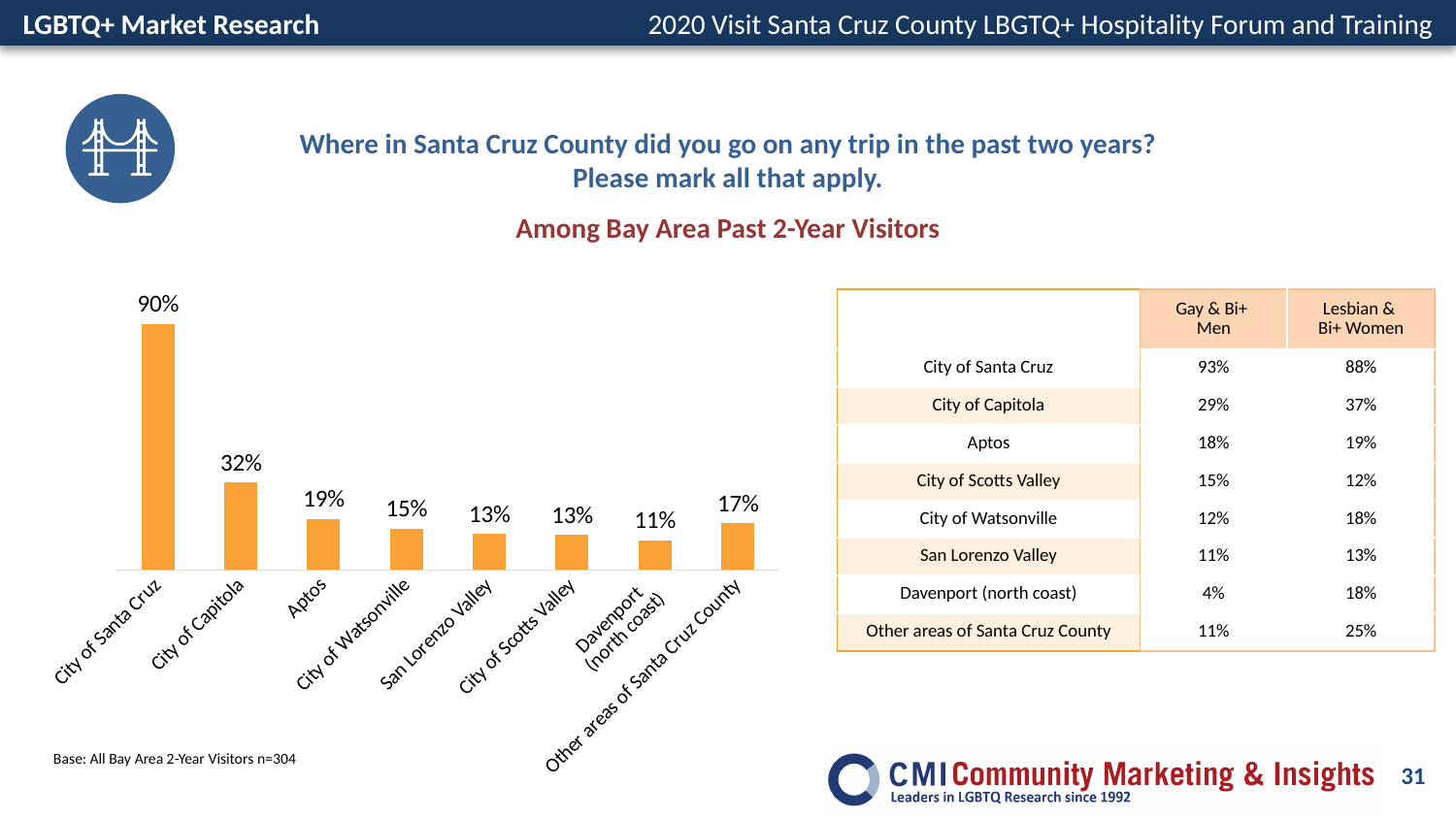
What kind of chart is shown on the slide? Bar chart What is the base sample size noted below the bar chart? n=304 What is the value for Davenport (north coast) in the bar chart? 11% What is the value for Other areas of Santa Cruz County in the bar chart? 17% Which category has the highest value in the bar chart? City of Santa Cruz How many categories are shown in the bar chart? 8 Which category has the lowest value in the bar chart? Davenport (north coast) Which is larger in the bar chart, the value for Aptos or the value for Other areas of Santa Cruz County? Aptos What is the difference between the values for Aptos and City of Watsonville in the bar chart? 4% What is the value for City of Capitola in the bar chart? 32% What is the difference between the values for City of Santa Cruz and City of Capitola in the bar chart? 58% What is the value for City of Santa Cruz in the bar chart? 90%